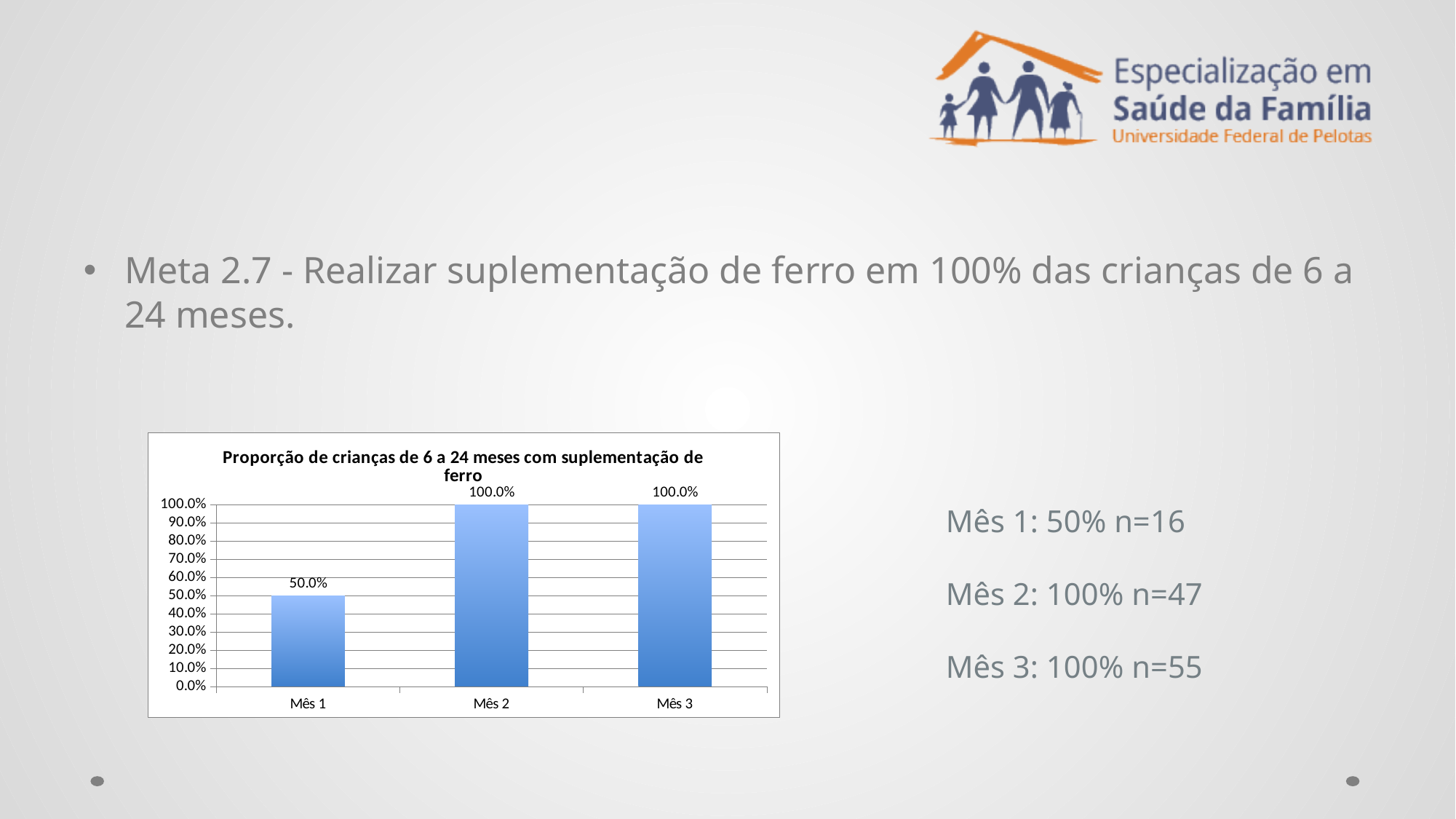
Is the value for Mês 1 greater or less than 60.0%? less What is the value for Mês 1? 50.0% What is the value for Mês 3? 100.0% What is the value for Mês 2? 100.0% Which month has the lowest value? Mês 1 What is the highest value shown on the y axis? 100.0% Which is larger, the value for Mês 1 or the value for Mês 3? Mês 3 What is the title of the chart? Proporção de crianças de 6 a 24 meses com suplementação de ferro How many months are shown on the x axis? 3 What is the difference between the values for Mês 2 and Mês 1? 50.0% What kind of chart is shown on the slide? bar chart Do the values rise or fall from Mês 1 to Mês 2? rise